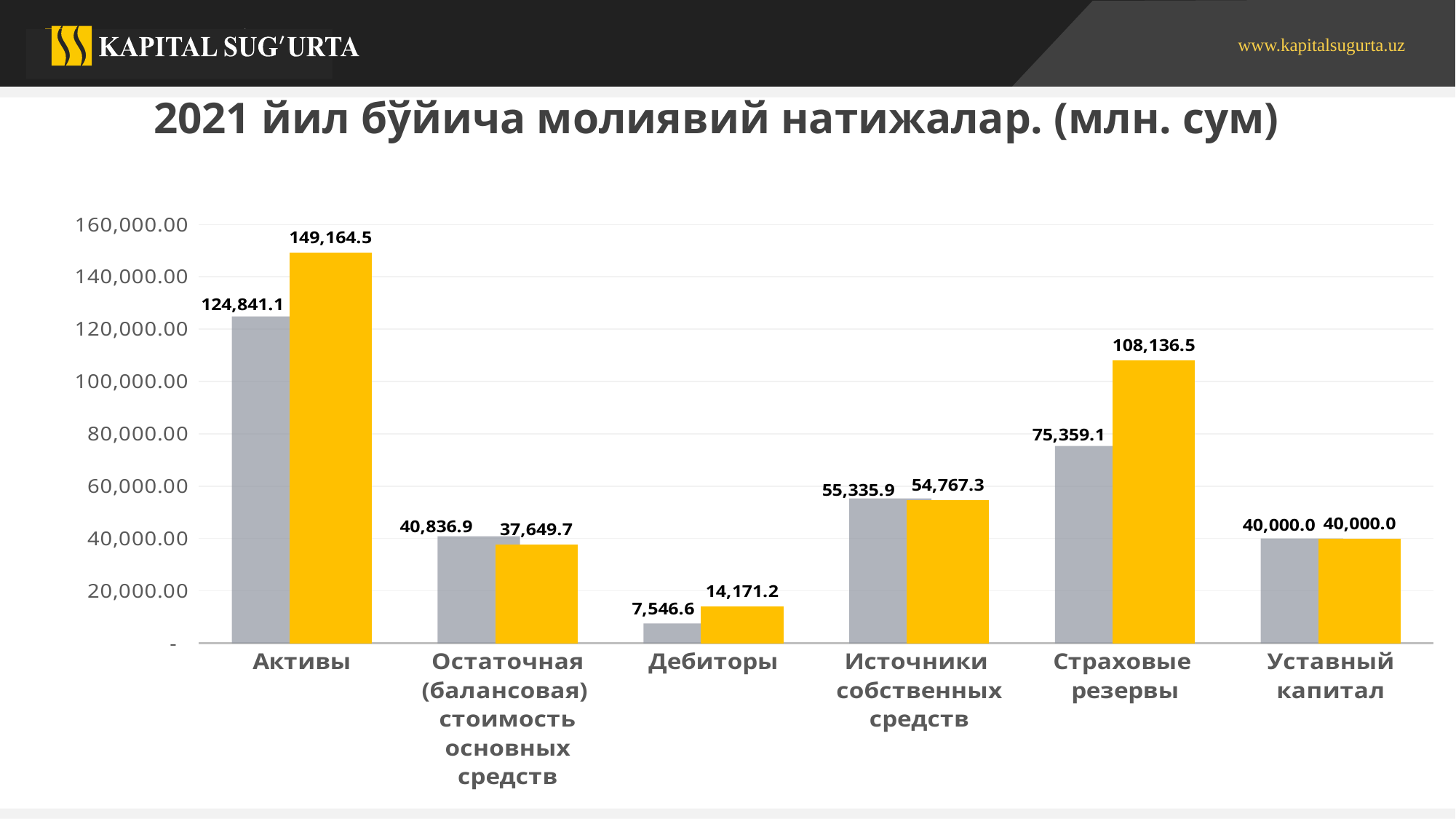
How many categories are shown on the x axis? 6 Which category has the highest yellow bar? Активы Which category has the lowest grey bar? Дебиторы What type of chart is shown on the slide? bar chart What is the title of the chart? 2021 йил бўйича молиявий натижалар. (млн. сум) What is the difference between the yellow and grey bars for Страховые резервы? 32,777.4 What is the value of the yellow bar for Активы? 149,164.5 For Остаточная (балансовая) стоимость основных средств, which bar is larger, the grey or the yellow? grey What is the value of the grey bar for Дебиторы? 7,546.6 What is the value of the grey bar for Страховые резервы? 75,359.1 What is the value of the yellow bar for Источники собственных средств? 54,767.3 What is the difference between the yellow and grey bars for Активы? 24,323.4